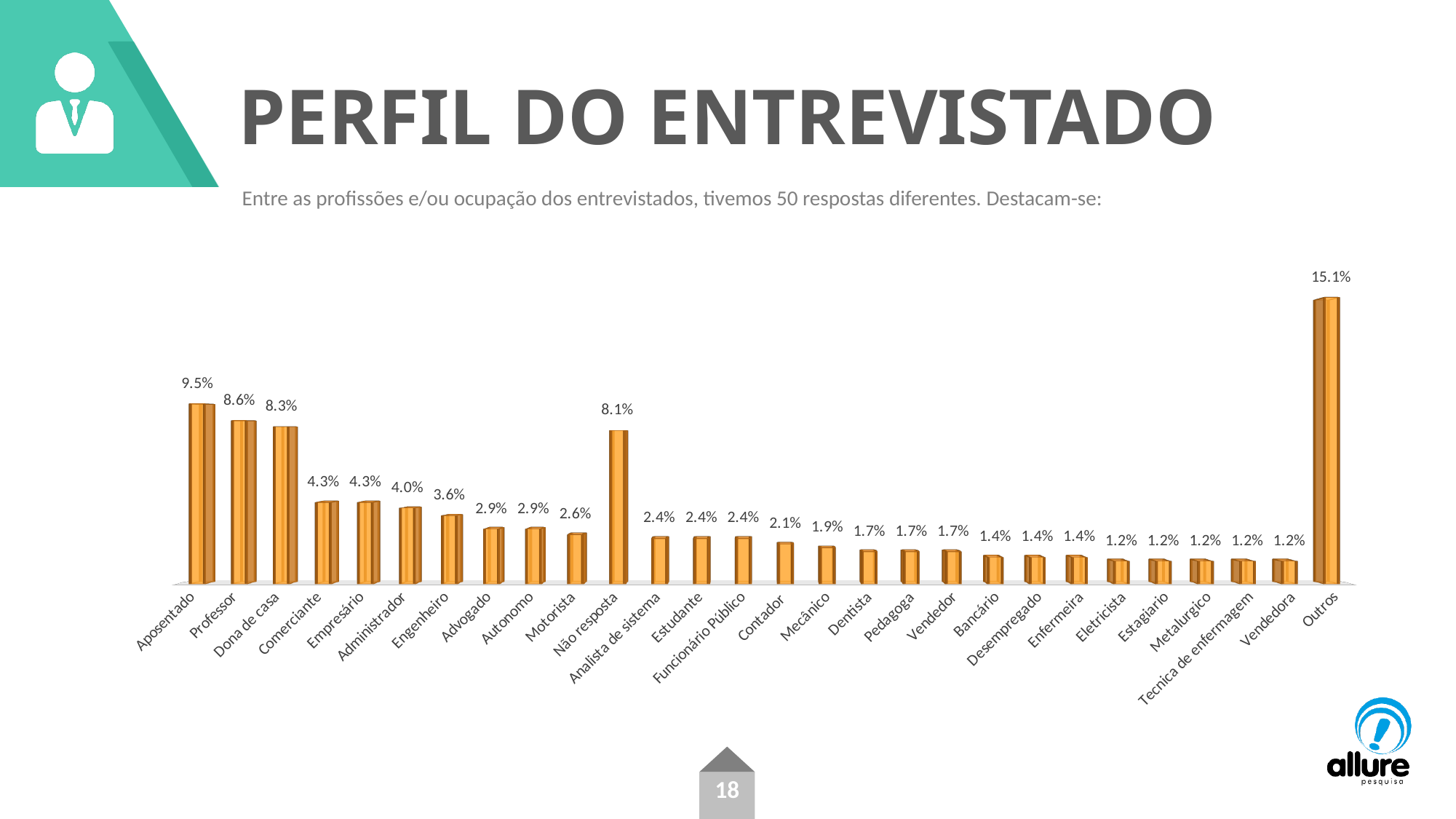
What is the title of the slide containing the chart? PERFIL DO ENTREVISTADO What kind of chart is shown on the slide? Bar chart What is the difference between the values for Outros and Aposentado? 5.6% What is the value for Engenheiro? 3.6% Which is larger, the value for Motorista or the value for Não resposta? Não resposta Which category has the highest value? Outros What is the value for Aposentado? 9.5% What is the value for Não resposta? 8.1% What is the difference between the values for Professor and Dona de casa? 0.3% How many categories are shown on the x axis? 28 What is the value for Contador? 2.1% Which is larger, the value for Comerciante or the value for Advogado? Comerciante